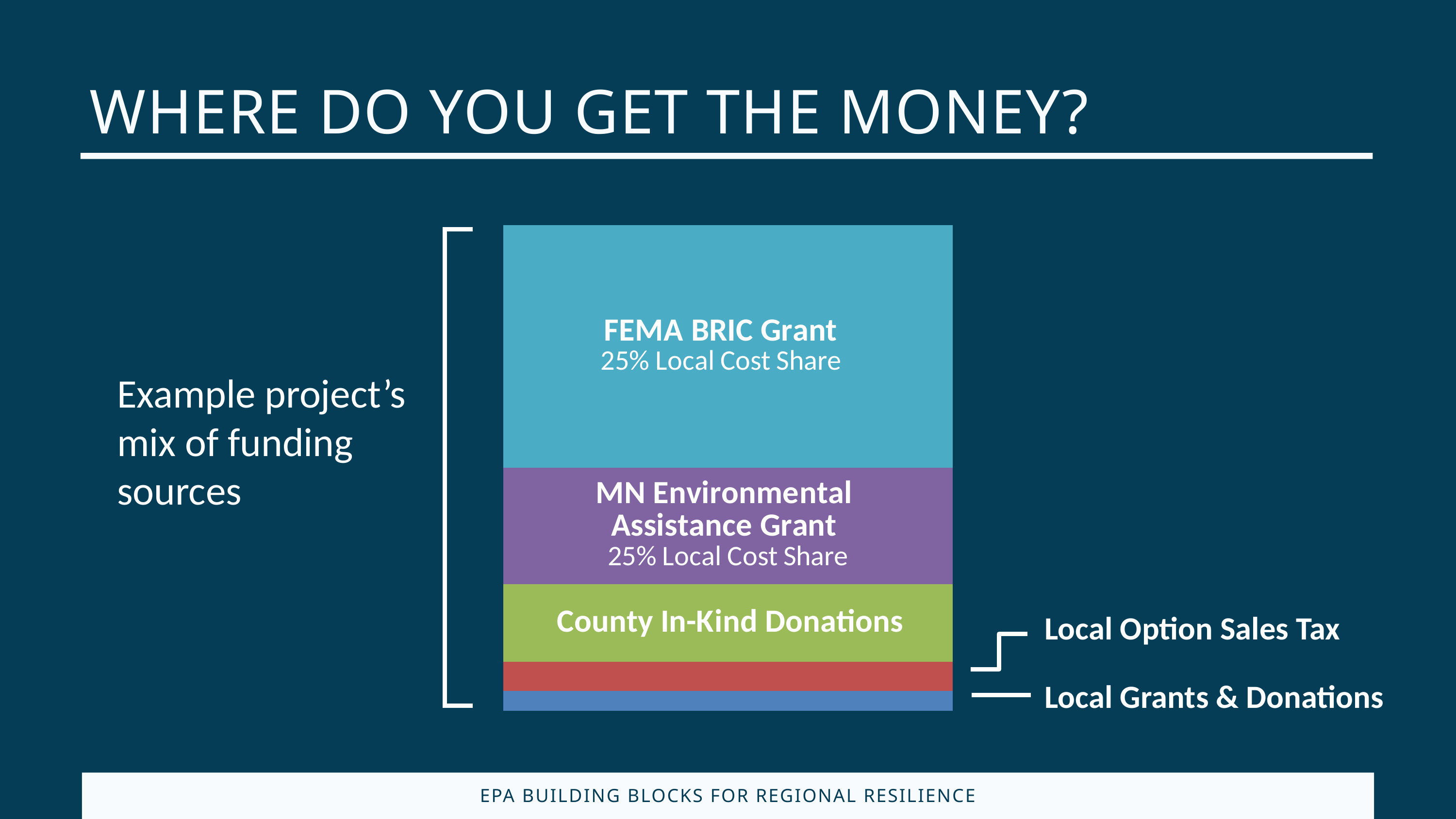
What kind of chart is shown on the slide? Stacked bar chart Which segment is larger: MN Environmental Assistance Grant or County In-Kind Donations? MN Environmental Assistance Grant Which funding source occupies the largest segment of the stacked bar? FEMA BRIC Grant Which funding source occupies the smallest segment of the stacked bar? Local Grants & Donations What colour is the County In-Kind Donations segment? Green What local cost share is printed for the FEMA BRIC Grant segment? 25% Local Cost Share Which segment is larger: FEMA BRIC Grant or County In-Kind Donations? FEMA BRIC Grant Which segment is larger: Local Option Sales Tax or Local Grants & Donations? Local Option Sales Tax Which funding source is shown at the very bottom of the stacked bar? Local Grants & Donations What local cost share is printed for the MN Environmental Assistance Grant segment? 25% Local Cost Share How many funding source segments make up the stacked bar on the slide? 5